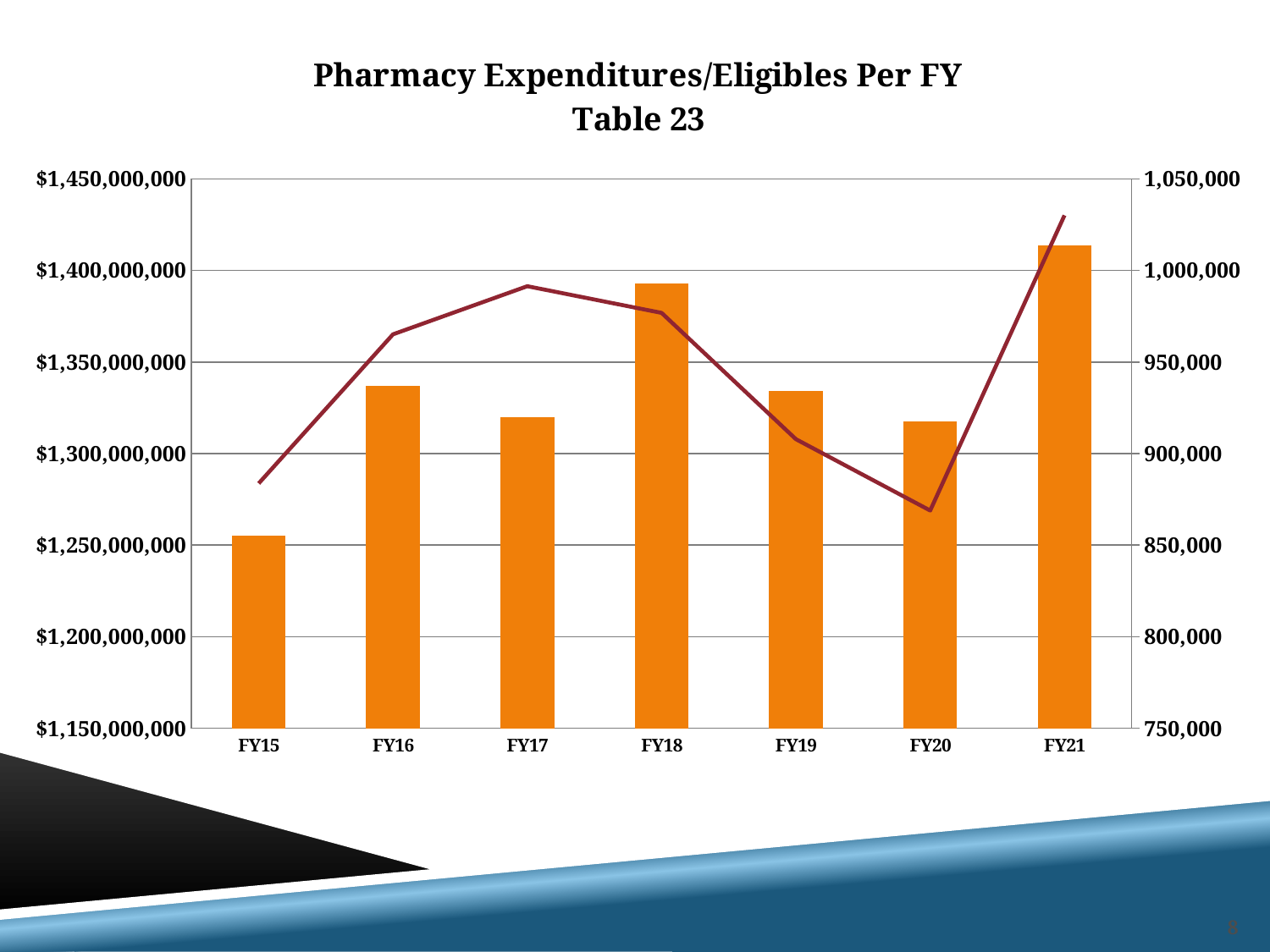
What kind of chart is shown on the slide? A bar chart with a line overlaid Which fiscal year has the shortest bar? FY15 What is the title of the chart? Pharmacy Expenditures/Eligibles Per FY Table 23 Which bar is taller, FY16 or FY17? FY16 Is the bar for FY18 greater or less than $1,350,000,000? greater Do the bars rise or fall from FY18 to FY20? fall Is the bar for FY21 greater or less than $1,400,000,000? greater Is the line value for FY21 (right axis) greater or less than 1,000,000? greater How many fiscal years are shown on the x axis? 7 Which fiscal year has the tallest bar? FY21